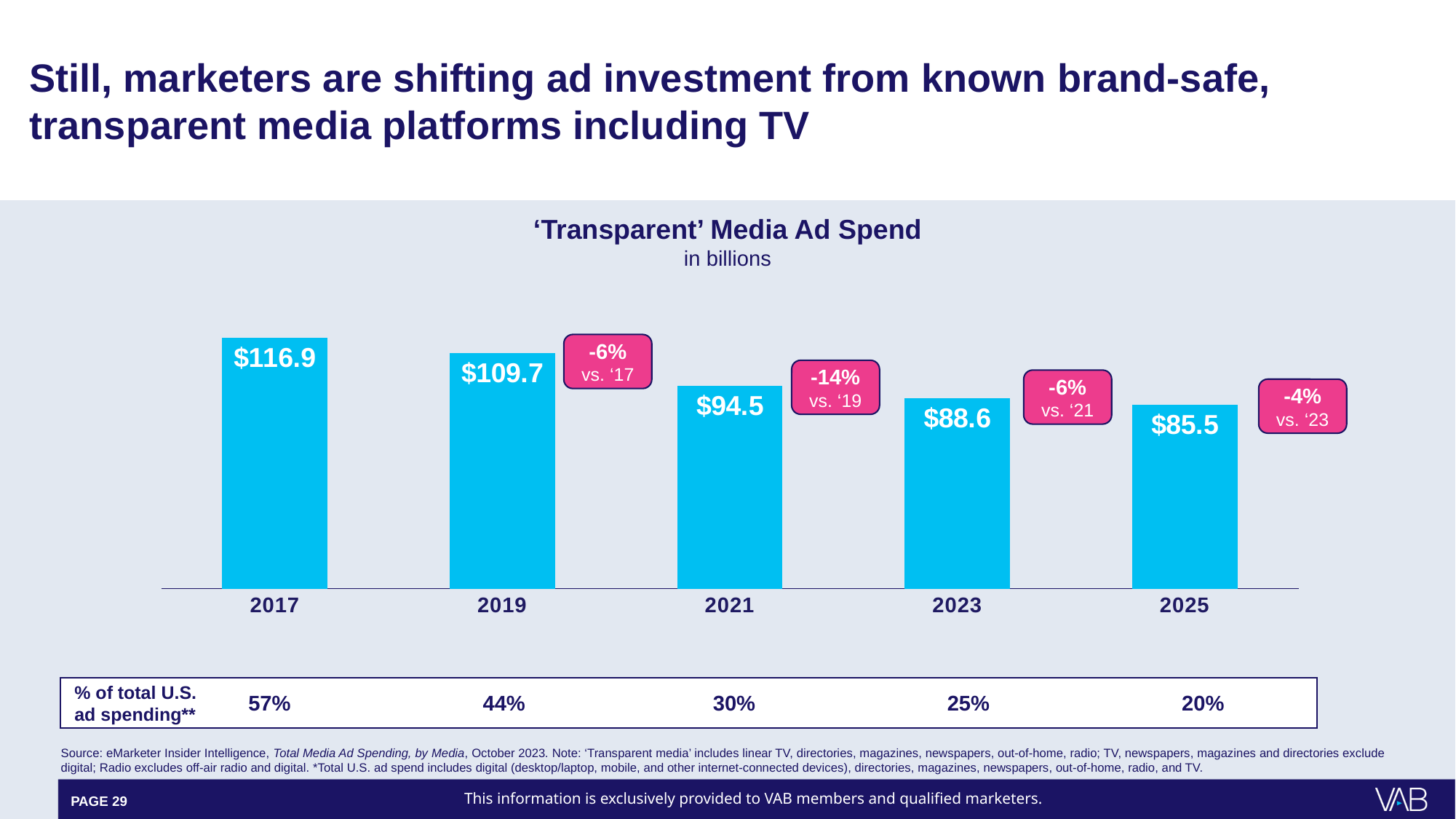
Which year has the lowest 'Transparent' Media Ad Spend? 2025 How many years are shown on the x axis of the chart? 5 What is the difference in 'Transparent' Media Ad Spend between 2017 and 2019? $7.2 What is the 'Transparent' Media Ad Spend value for 2021? $94.5 What kind of chart is used to show 'Transparent' Media Ad Spend? Bar chart Which year has a larger 'Transparent' Media Ad Spend, 2019 or 2023? 2019 What is the 'Transparent' Media Ad Spend value for 2025? $85.5 Which year has the highest 'Transparent' Media Ad Spend? 2017 What percentage change vs. '19 is shown for 2021? -14% Do the 'Transparent' Media Ad Spend values rise or fall from 2017 to 2025? Fall What is the difference in 'Transparent' Media Ad Spend between 2021 and 2023? $5.9 What is the 'Transparent' Media Ad Spend value for 2017? $116.9